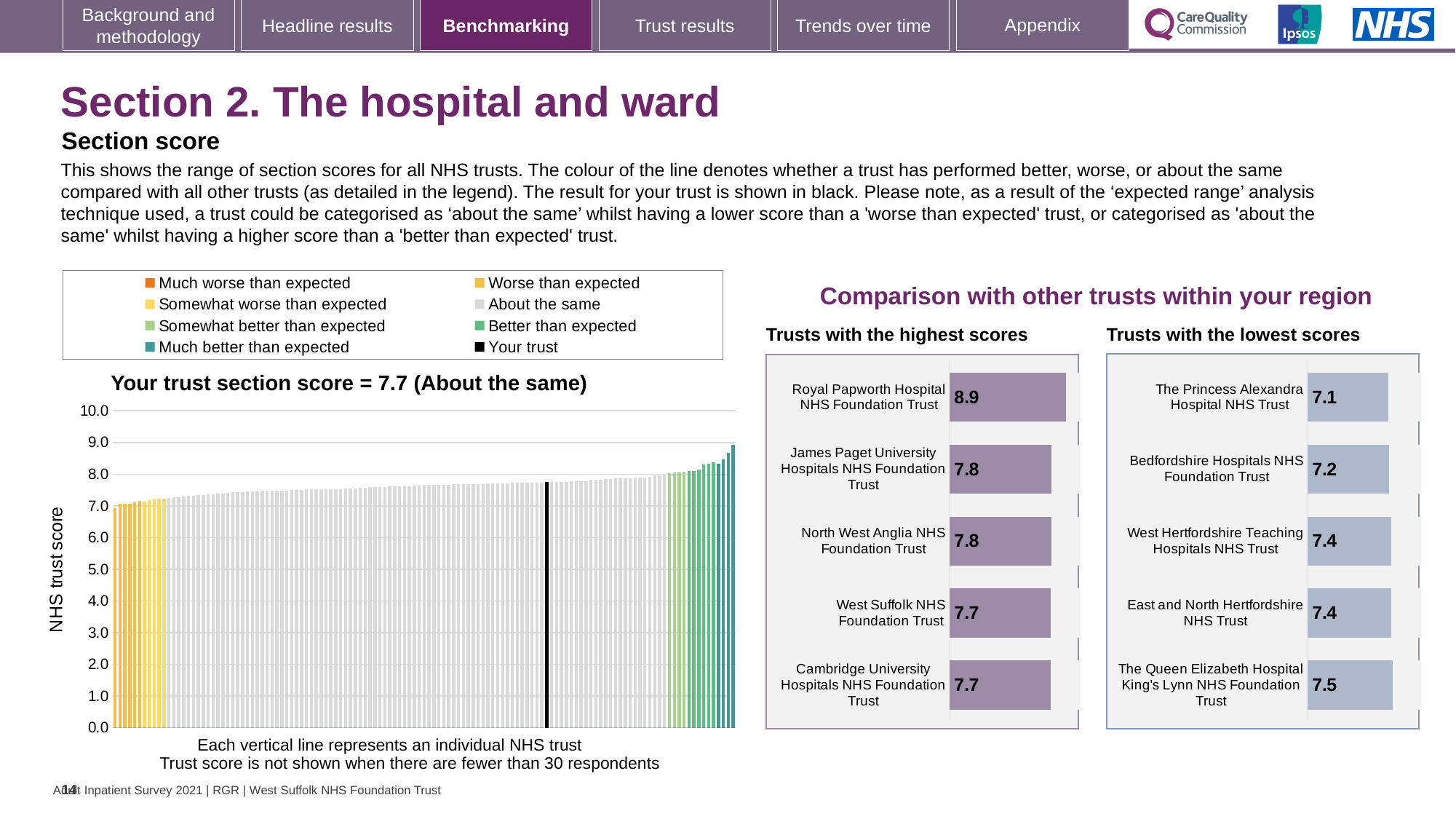
According to the title of the left-hand chart, what is your trust's section score? 7.7 In the 'Trusts with the lowest scores' chart, what is the score for The Princess Alexandra Hospital NHS Trust? 7.1 How many trusts are shown in the 'Trusts with the highest scores' chart? 5 In the 'Trusts with the highest scores' chart, what is the score for Royal Papworth Hospital NHS Foundation Trust? 8.9 In the 'Trusts with the highest scores' chart, what is the difference between the scores of Royal Papworth Hospital NHS Foundation Trust and Cambridge University Hospitals NHS Foundation Trust? 1.2 How many entries does the legend above the left-hand chart list? 8 What kind of chart is the 'Your trust section score' chart on the left of the slide? Bar chart In the 'Trusts with the lowest scores' chart, which trust has the lowest score? The Princess Alexandra Hospital NHS Trust According to the title of the left-hand chart, which category does your trust's section score fall into? About the same In the 'Trusts with the lowest scores' chart, which has the higher score: Bedfordshire Hospitals NHS Foundation Trust or The Queen Elizabeth Hospital King's Lynn NHS Foundation Trust? The Queen Elizabeth Hospital King's Lynn NHS Foundation Trust In the 'Trusts with the lowest scores' chart, what is the difference between the scores of The Queen Elizabeth Hospital King's Lynn NHS Foundation Trust and The Princess Alexandra Hospital NHS Trust? 0.4 In the 'Trusts with the highest scores' chart, which trust has the highest score? Royal Papworth Hospital NHS Foundation Trust